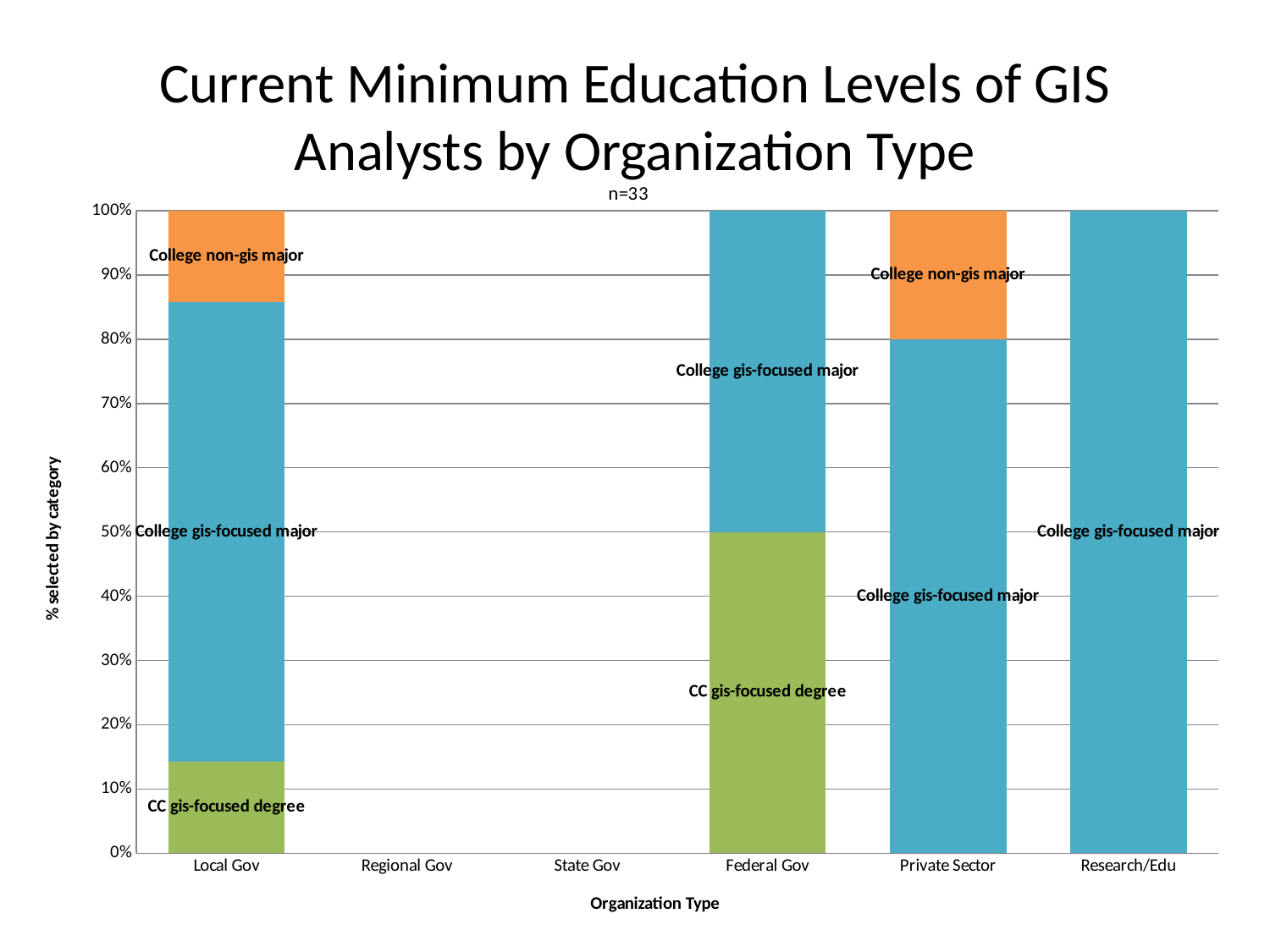
Which organization types include a College non-gis major segment? Local Gov and Private Sector What kind of chart is shown on the slide? Stacked bar chart What percentage does the CC gis-focused degree segment reach for Federal Gov? 50% Which has the larger CC gis-focused degree share, Local Gov or Federal Gov? Federal Gov How many organization types are listed along the x axis? 6 Is the College non-gis major share for Local Gov greater or less than 20%? less Which organization types have no bar plotted? Regional Gov and State Gov Which organization type has the largest College gis-focused major share? Research/Edu What percentage of the Private Sector bar is College non-gis major? 20% What percentage of the Federal Gov bar is College gis-focused major? 50% What percentage of the Research/Edu bar is College gis-focused major? 100% Is the CC gis-focused degree share for Local Gov greater or less than 20%? less